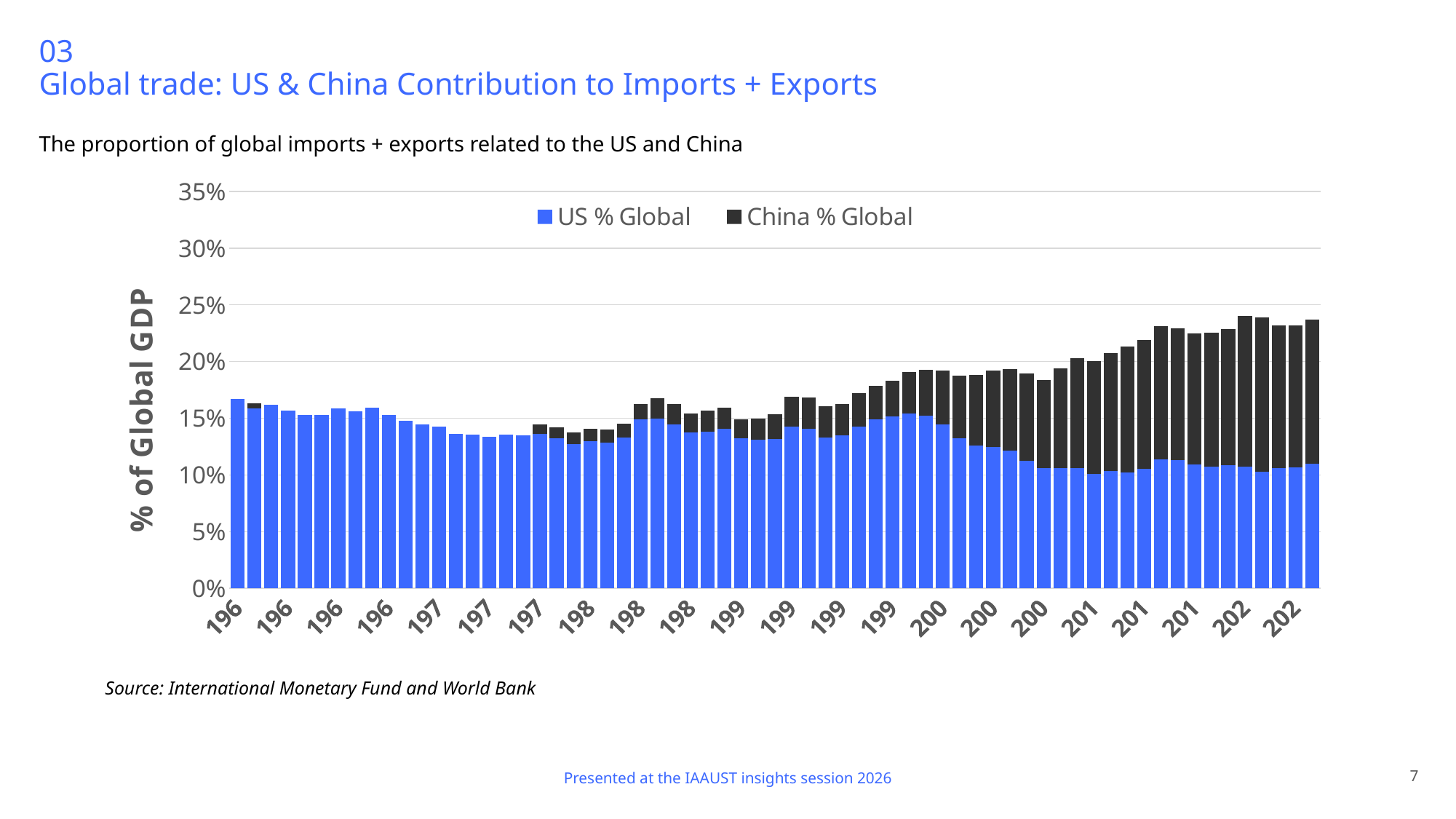
Does the China % Global portion of the bars generally rise or fall from left to right along the x axis? Rise Is the total height of the leftmost bar greater or less than 15%? greater Which colour represents the China % Global series? Black What are the two series named in the legend? US % Global and China % Global What kind of chart is shown on the slide? Stacked bar chart What is the title of the y axis? % of Global GDP Does the US % Global portion of the bars generally rise or fall from left to right along the x axis? Fall In the leftmost bar, which series has the larger value, US % Global or China % Global? US % Global How many series does the legend list? 2 Is the total height of the rightmost bar greater or less than 20%? greater Is the US % Global portion of the rightmost bar greater or less than 15%? less